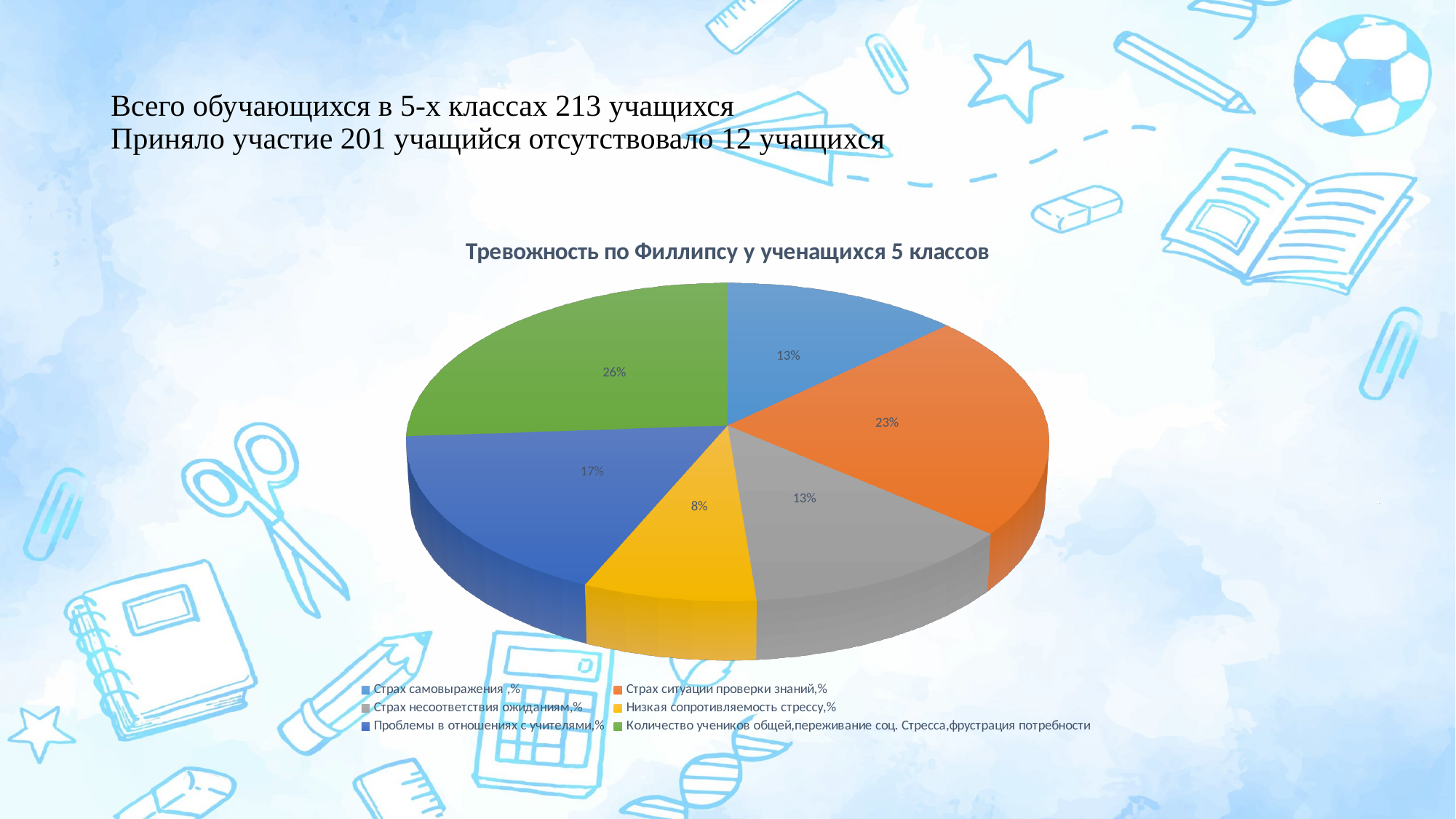
What percentage is shown for the slice "Страх самовыражения ,%"? 13% Which slice has the smallest share of the pie? Низкая сопротивляемость стрессу,% What percentage is shown for the slice "Низкая сопротивляемость стрессу,%"? 8% How many slices does the pie chart have? 6 What is the difference in percentage points between "Страх ситуации проверки знаний,%" and "Низкая сопротивляемость стрессу,%"? 15 What colour is the slice for "Низкая сопротивляемость стрессу,%"? yellow What is the title of the chart? Тревожность по Филлипсу у ученащихся 5 классов What percentage is shown for the slice "Проблемы в отношениях с учителями,%"? 17% What kind of chart is shown on the slide? pie chart Which is larger: "Проблемы в отношениях с учителями,%" or "Страх несоответствия ожиданиям,%"? Проблемы в отношениях с учителями,% What percentage is shown for the slice "Страх ситуации проверки знаний,%"? 23% Which slice has the largest share of the pie? Количество учеников общей,переживание соц. Стресса,фрустрация потребности